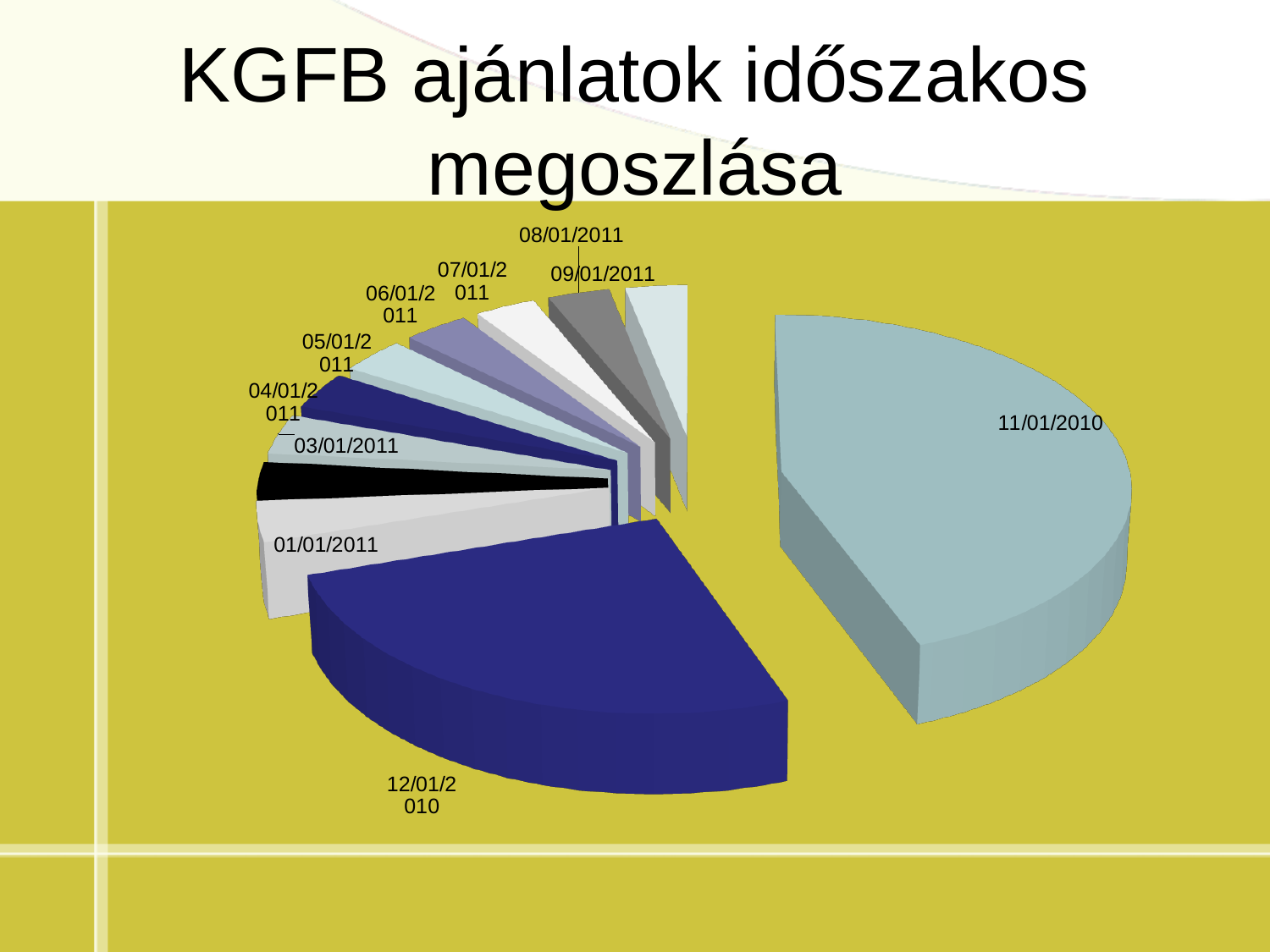
Which slice is larger, 11/01/2010 or 05/01/2011? 11/01/2010 What kind of chart is shown on the slide? pie chart What colour is the slice for 12/01/2010? dark blue Which category has the second largest slice of the pie? 12/01/2010 Which slice is larger, 12/01/2010 or 08/01/2011? 12/01/2010 Which category has the largest slice of the pie? 11/01/2010 Which slice is larger, 11/01/2010 or 12/01/2010? 11/01/2010 What is the title of the chart on the slide? KGFB ajánlatok időszakos megoszlása